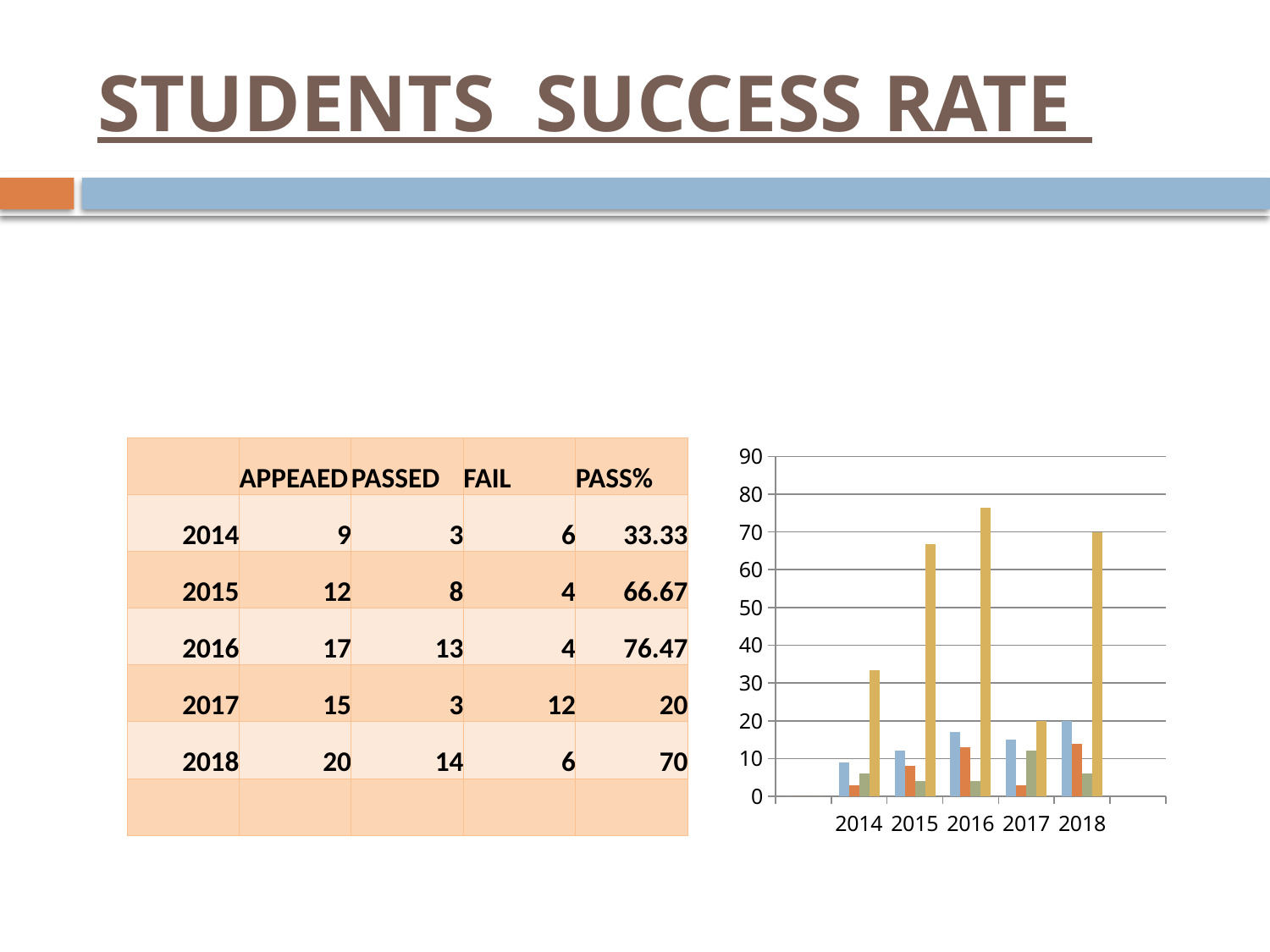
Which year has the taller tallest bar, 2016 or 2017? 2016 From 2014 to 2016, does the tallest bar in each year rise or fall? rise Is the tallest bar for 2018 greater or less than 60? greater What kind of chart is shown on the slide? bar chart Is the tallest bar for 2014 greater or less than 40? less Which year's tallest bar is the lowest among the years? 2017 What is the highest value shown on the chart's vertical axis? 90 Which year has the tallest bar in the chart? 2016 How many bars are plotted for each year in the chart? 4 Is the tallest bar for 2015 greater or less than 60? greater How many years are shown on the x axis of the chart? 5